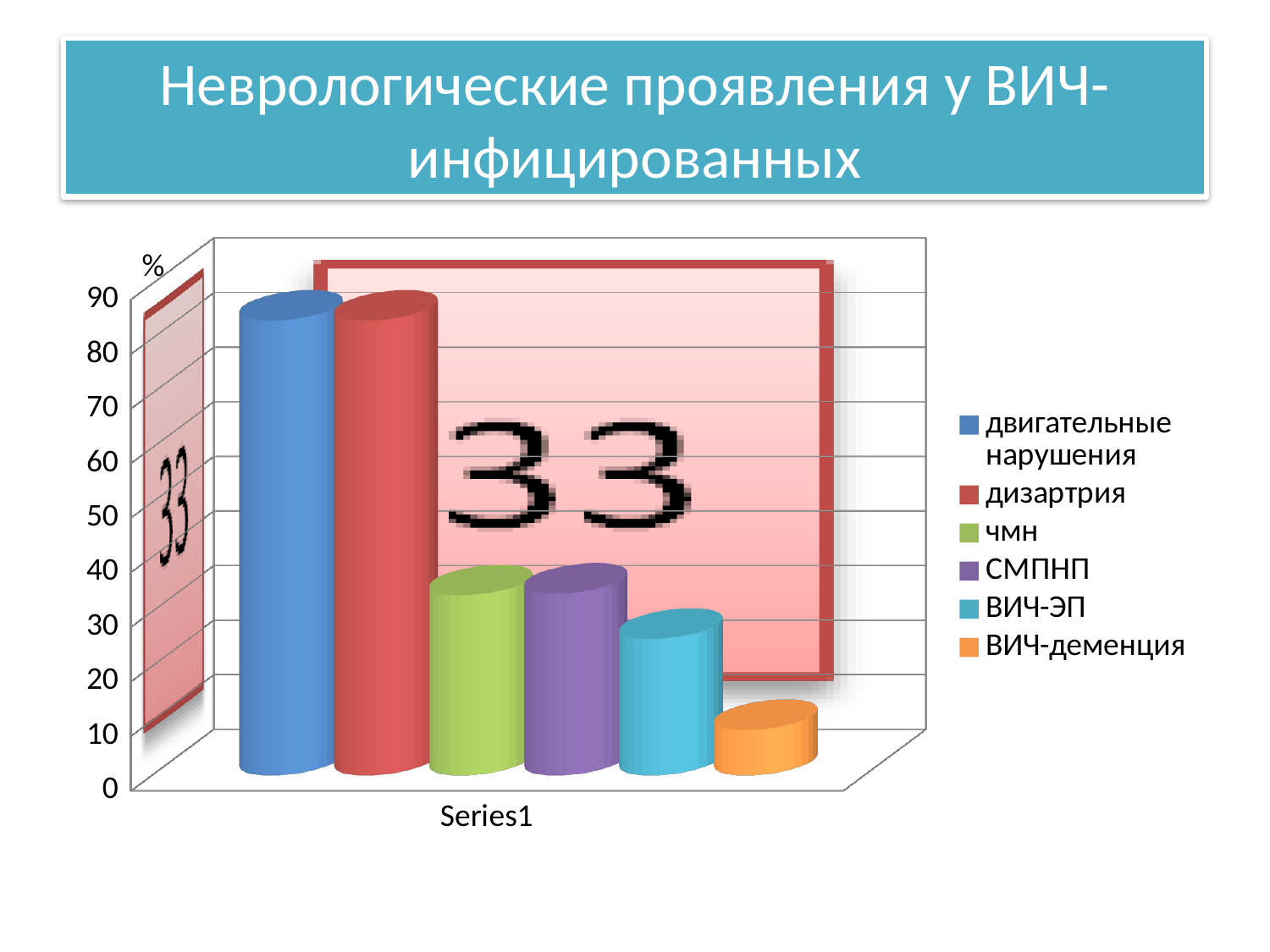
Is the value for СМПНП greater or less than 50? less What is the title of the slide? Неврологические проявления у ВИЧ-инфицированных Which is larger, the value for чмн or the value for ВИЧ-деменция? чмн What kind of chart is shown on the slide? bar chart Which category has the lowest value? ВИЧ-деменция Is the value for дизартрия greater or less than 70? greater Is the value for ВИЧ-ЭП greater or less than 40? less How many entries does the legend list? 6 Which is larger, the value for дизартрия or the value for ВИЧ-ЭП? дизартрия